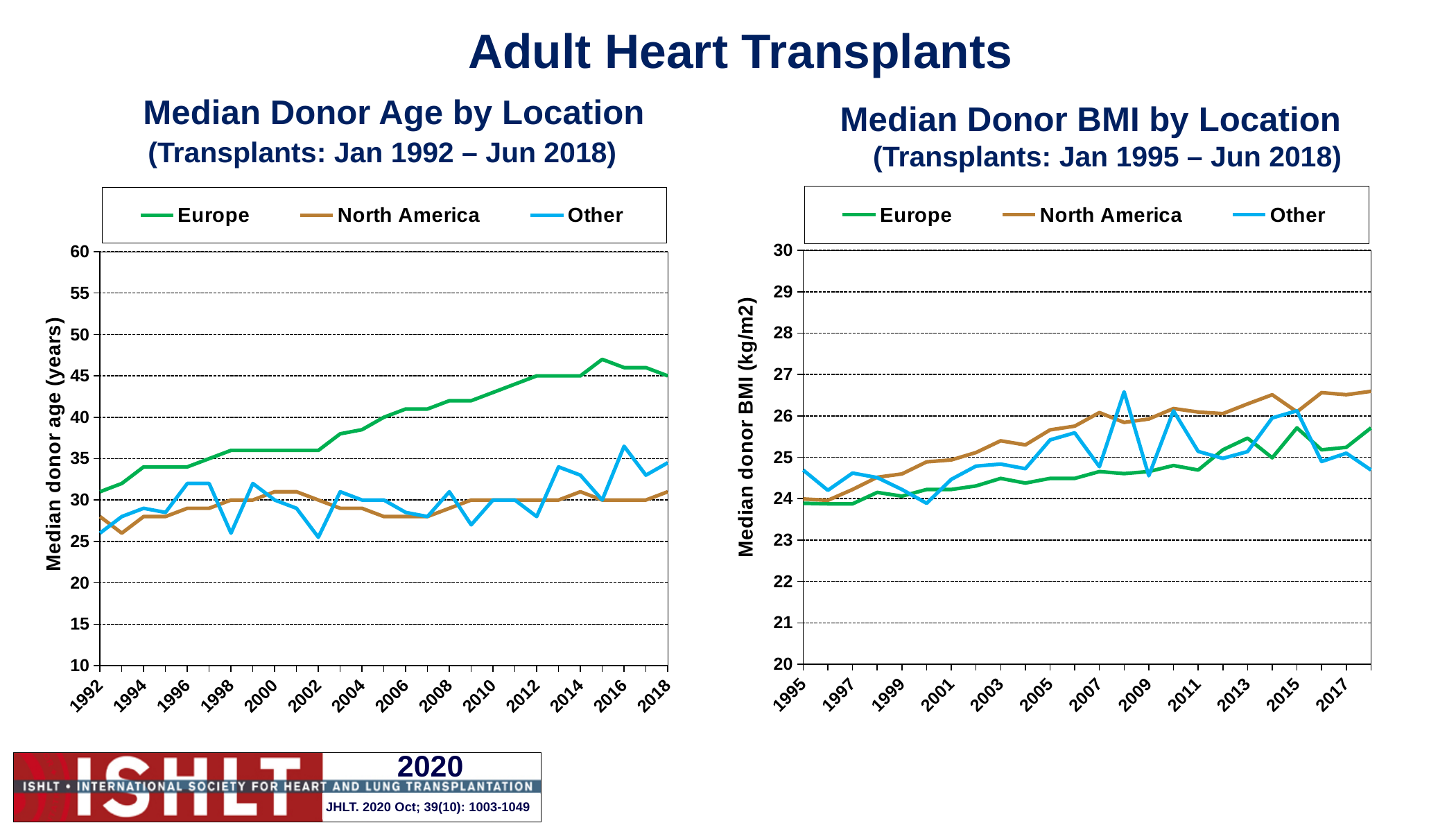
In the Median Donor Age by Location chart, is the value for Europe in 2018 greater or less than 40? greater In the Median Donor BMI by Location chart, does the North America series generally rise or fall from 1995 to 2018? rise What kind of chart is the Median Donor Age by Location chart? line chart How many series does the legend of the Median Donor BMI by Location chart list? 3 In the Median Donor Age by Location chart, does the Europe series generally rise or fall from 1992 to 2018? rise What is the y-axis label of the Median Donor BMI by Location chart? Median donor BMI (kg/m2) In the Median Donor BMI by Location chart, is the value for Europe in 1995 greater or less than 25? less In the Median Donor BMI by Location chart, is the value for North America in 2018 greater or less than 26? greater In the Median Donor BMI by Location chart, which series has the highest value in 2018? North America In the Median Donor Age by Location chart, which series has the highest value in 2018? Europe